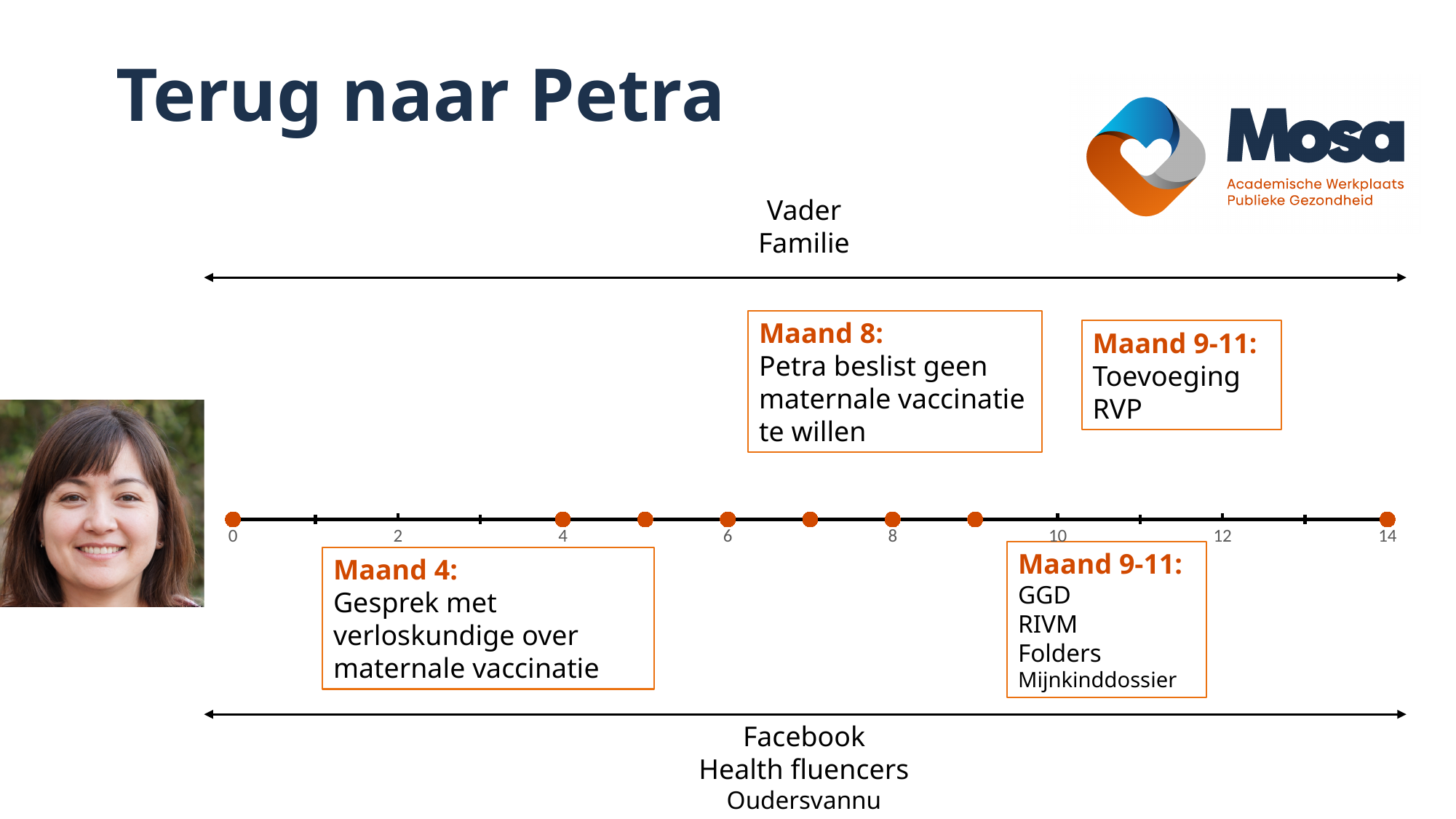
What is the lowest value labelled on the timeline axis? 0 What is the spacing between consecutive numeric labels on the timeline axis? 2 How many orange markers lie between month 4 and month 9 inclusive? 6 Is the marker for the 'Maand 8' event placed at a value greater or less than 10 on the axis? less What is the difference in months between the last marker (14) and the first marker (0)? 14 At which month is the first orange marker after month 0 placed? 4 Which months does the 'Toevoeging RVP' annotation box refer to? Maand 9-11 What kind of chart is shown on the slide? timeline Which event is annotated at Maand 4 on the timeline? Gesprek met verloskundige over maternale vaccinatie How many orange markers are plotted on the timeline axis? 8 What is the highest value labelled on the timeline axis? 14 At which month is the last orange marker on the timeline placed? 14